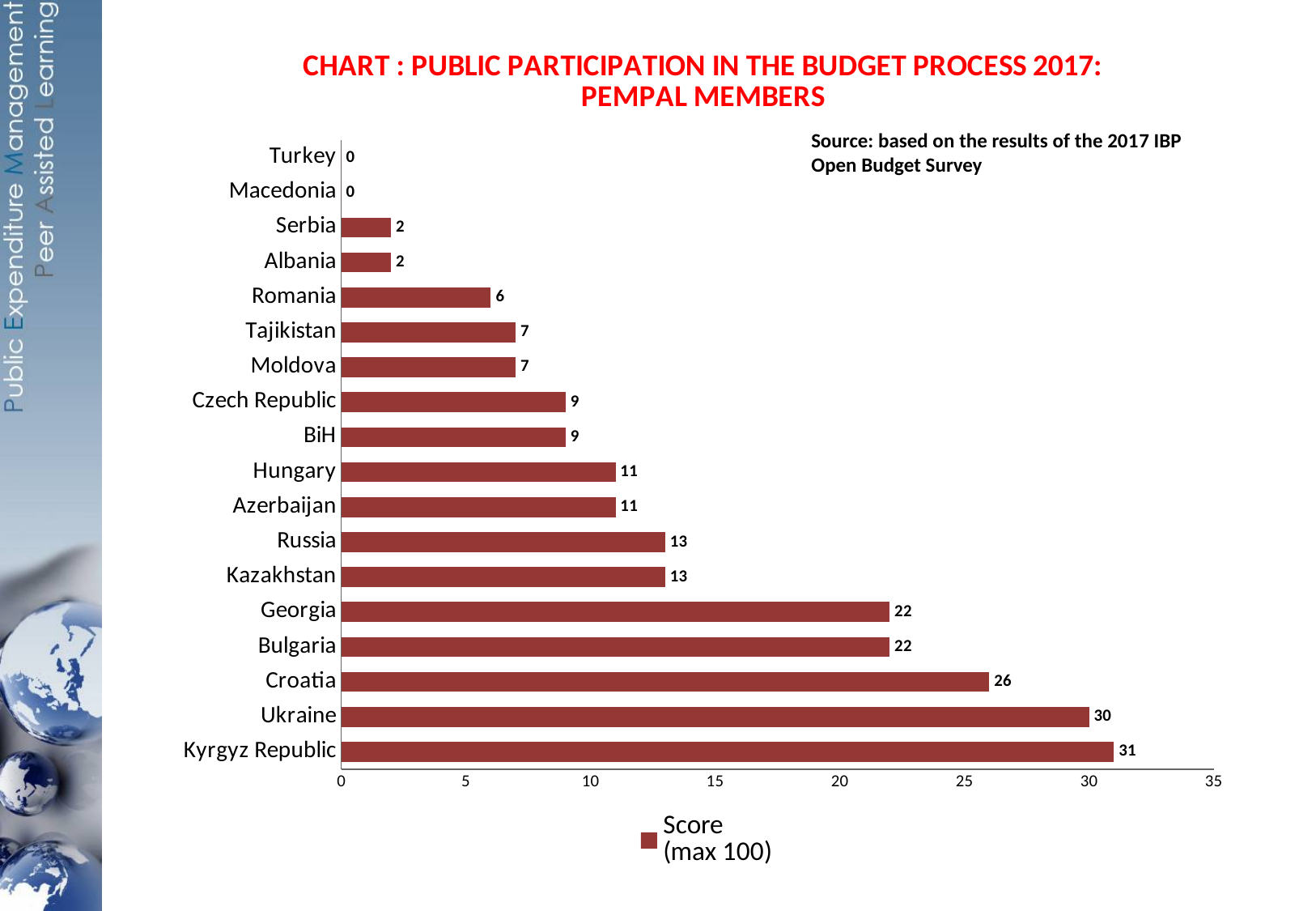
What is the legend entry for the series in the chart? Score (max 100) Which country has the highest score? Kyrgyz Republic How many series does the legend list? 1 What is the difference between the scores of Ukraine and Russia? 17 What type of chart is shown on the slide? Bar chart What is the score for Romania? 6 How many countries are shown in the chart? 18 What is the difference between the scores of Croatia and Hungary? 15 Is the score for Ukraine greater or less than 25? greater Which has a higher score, Bulgaria or Kazakhstan? Bulgaria What is the score for Croatia? 26 What is the score for Georgia? 22